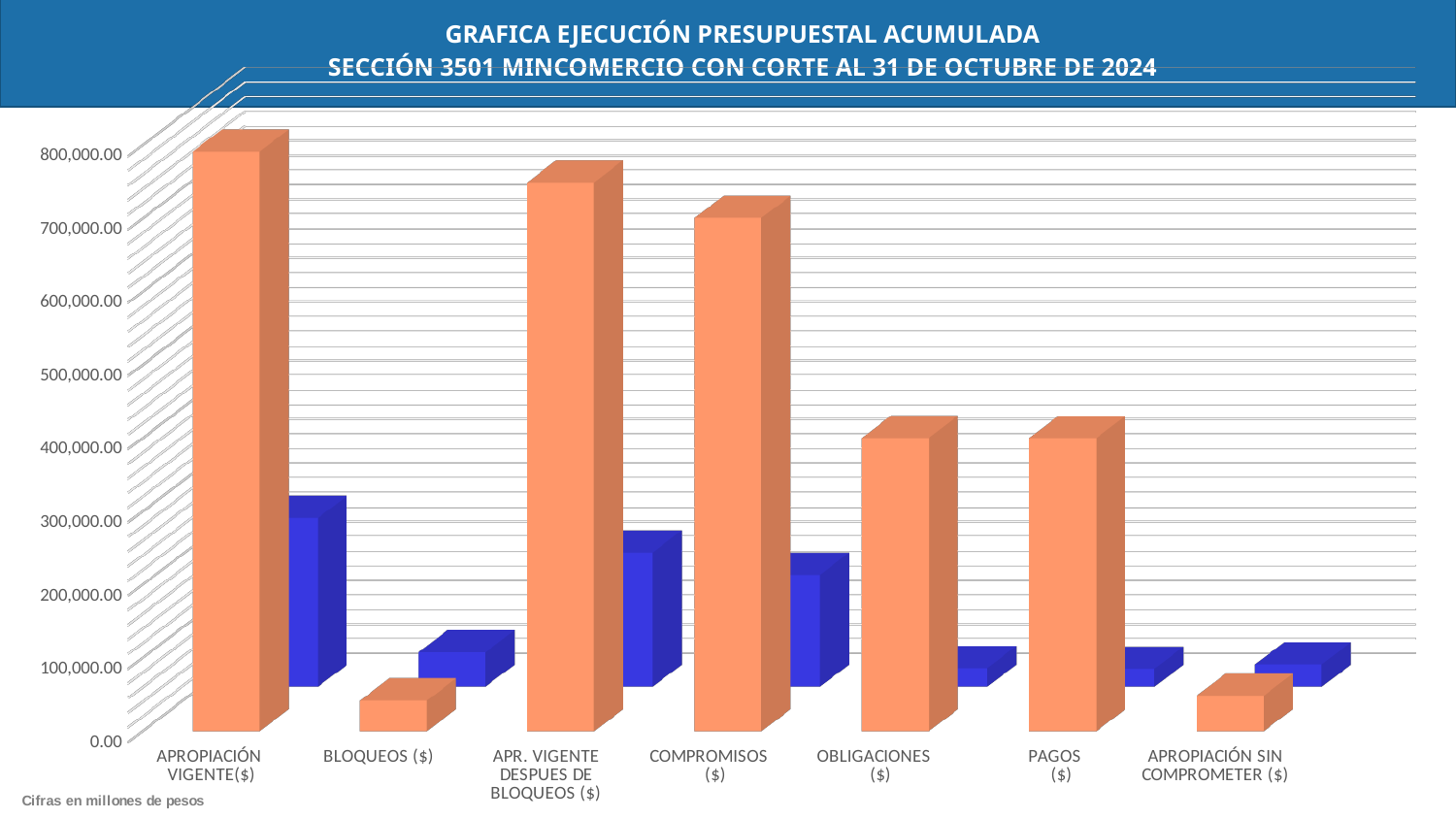
How many categories are shown along the x axis of the chart? 7 What kind of chart is shown on the slide? bar chart Is the orange bar for COMPROMISOS ($) greater or less than 600,000.00? greater Which orange bar is taller, COMPROMISOS ($) or OBLIGACIONES ($)? COMPROMISOS ($) Is the orange bar for APR. VIGENTE DESPUES DE BLOQUEOS ($) greater or less than 700,000.00? greater Is the orange bar for OBLIGACIONES ($) greater or less than 300,000.00? greater According to the note below the chart, in what units are the figures expressed? millones de pesos Which blue bar is taller, APROPIACIÓN VIGENTE($) or BLOQUEOS ($)? APROPIACIÓN VIGENTE($) Which category has the tallest orange bar? APROPIACIÓN VIGENTE($)